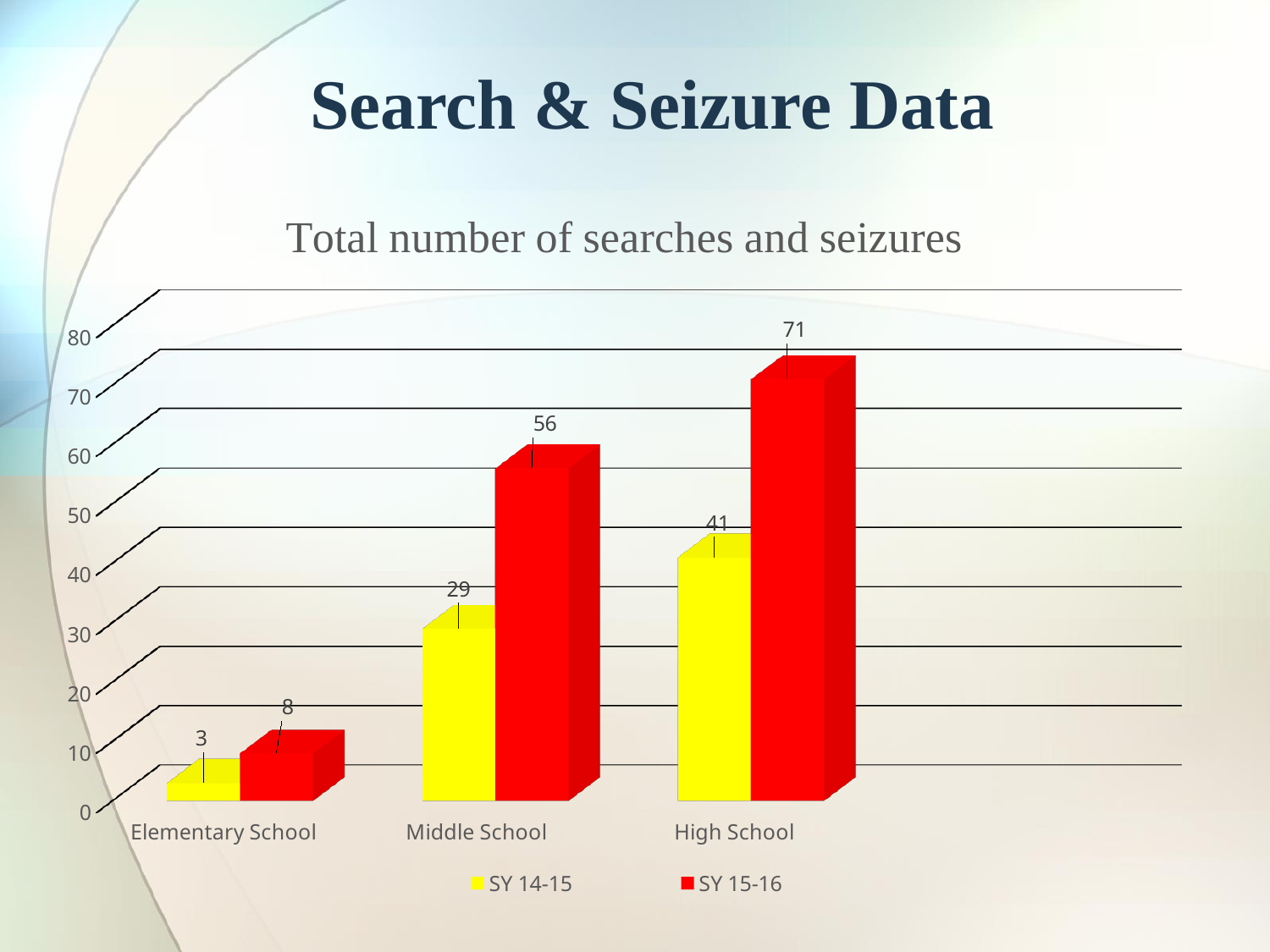
What is the title of the chart? Total number of searches and seizures What is the value for High School in the SY 15-16 series? 71 How many series does the legend list? 2 What is the value for Middle School in the SY 15-16 series? 56 Which school level has the lowest value in the SY 15-16 series? Elementary School What is the difference between the SY 15-16 and SY 14-15 values for High School? 30 How many school levels are shown on the x axis? 3 Which school level has the highest value in the SY 14-15 series? High School Which is larger for Middle School: the SY 14-15 value or the SY 15-16 value? SY 15-16 What is the difference between the SY 15-16 and SY 14-15 values for Middle School? 27 What is the value for Elementary School in the SY 14-15 series? 3 What kind of chart is shown on the slide? Bar chart